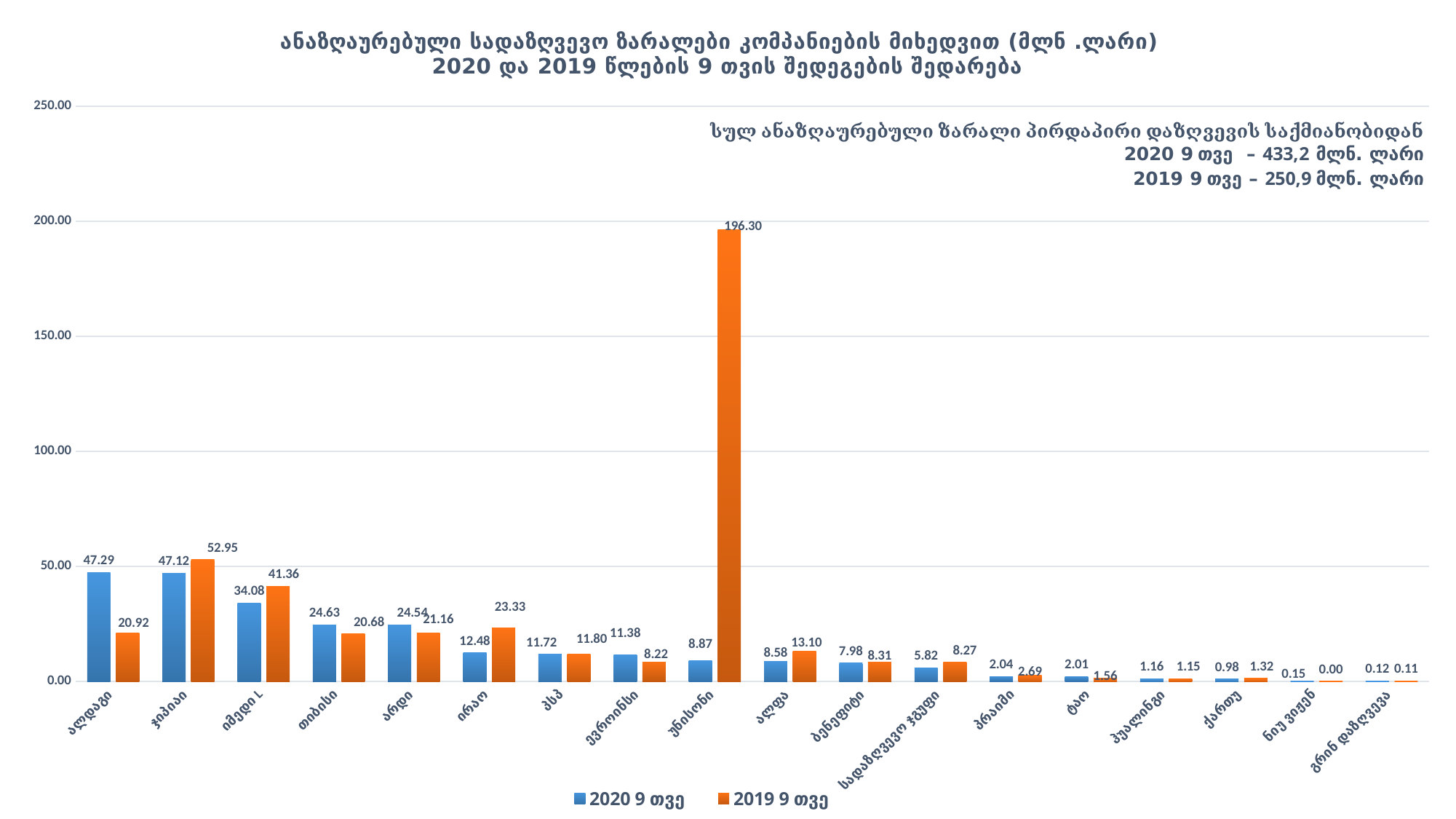
Which category has the lowest value in the 2019 9 თვე series? ნიუ ვიჟენ Which is larger for იმედი L: the 2020 9 თვე value or the 2019 9 თვე value? 2019 9 თვე Is the 2019 9 თვე value for უნისონი greater or less than 150.00? greater What is the value for უნისონი in the 2019 9 თვე series? 196.30 How many categories are shown on the x axis? 18 How many series does the legend list? 2 What is the difference between the 2019 9 თვე and 2020 9 თვე values for ჯიპიაი? 5.83 What is the value for ირაო in the 2019 9 თვე series? 23.33 Which category has the highest value in the 2019 9 თვე series? უნისონი Which category has the highest value in the 2020 9 თვე series? ალდაგი What is the value for ალდაგი in the 2020 9 თვე series? 47.29 What kind of chart is shown on the slide? bar chart